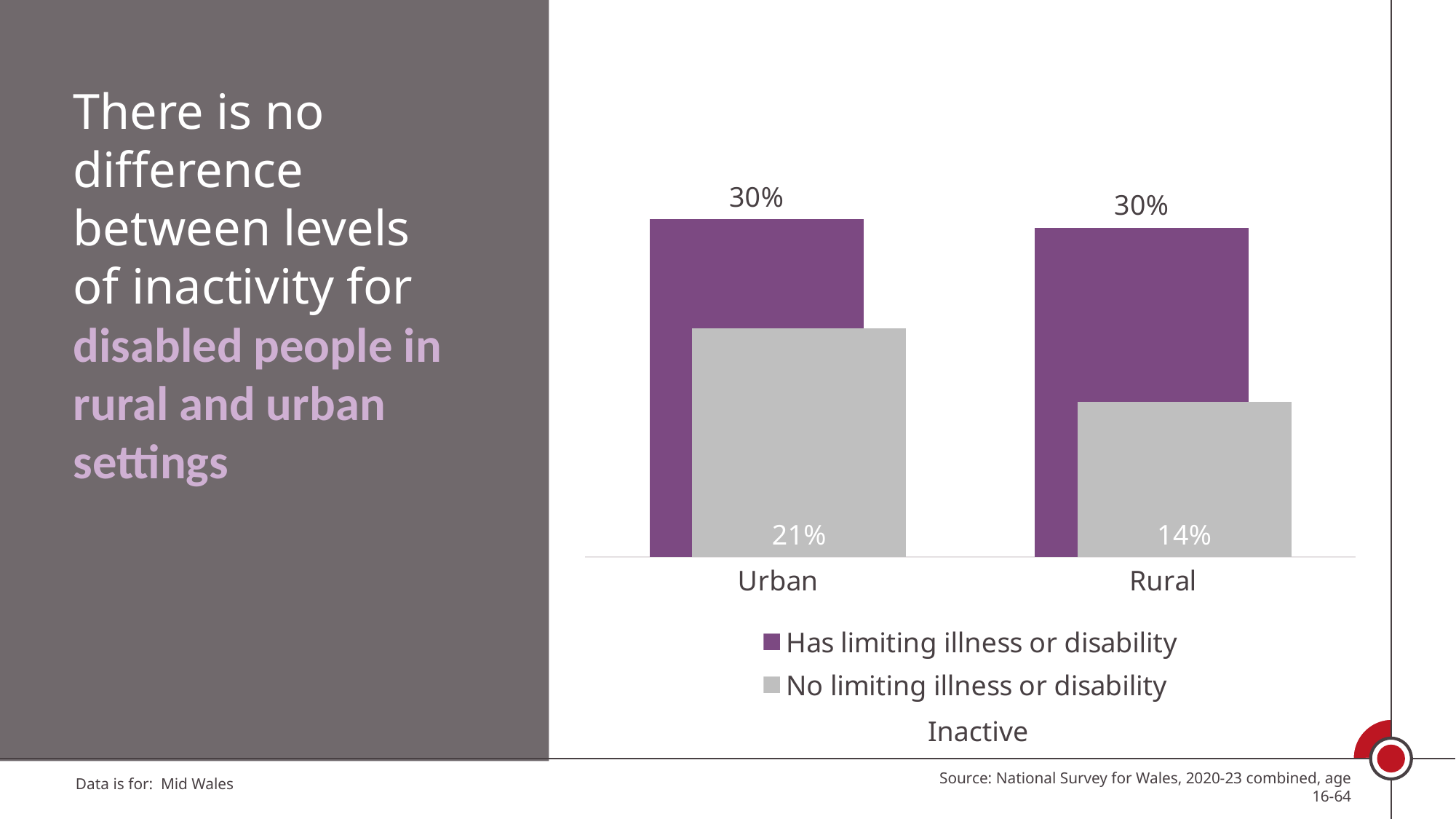
What is the difference between the Urban and Rural values for 'No limiting illness or disability'? 7% What is the value for 'Has limiting illness or disability' in the Rural category? 30% What is the value for 'Has limiting illness or disability' in the Urban category? 30% How many categories are shown on the x axis? 2 What kind of chart is shown on the slide? Bar chart Which category has the lowest value for 'No limiting illness or disability'? Rural Which is larger in the Urban category: 'Has limiting illness or disability' or 'No limiting illness or disability'? Has limiting illness or disability What is the title of the chart? Inactive What is the value for 'No limiting illness or disability' in the Rural category? 14% What is the difference between the 'Has limiting illness or disability' and 'No limiting illness or disability' values in the Rural category? 16% What is the value for 'No limiting illness or disability' in the Urban category? 21% How many series does the legend list? 2